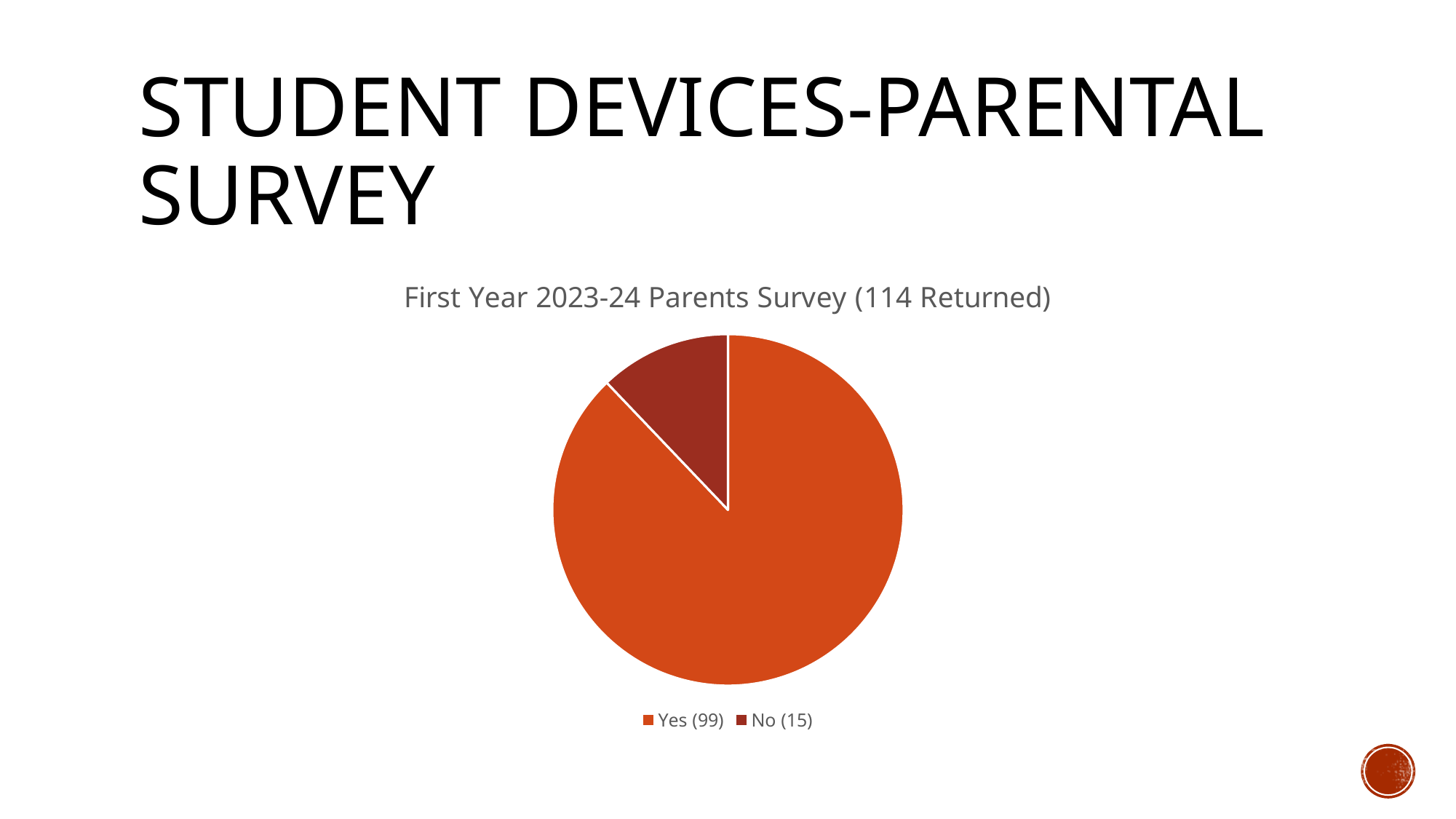
What colour is the Yes slice of the pie? orange What is the difference between the number of Yes and No responses? 84 How many parents answered No according to the legend? 15 How many slices does the pie chart have? 2 Which is larger, the Yes count or the No count? Yes What is the title of the chart? First Year 2023-24 Parents Survey (114 Returned) How many parents answered Yes according to the legend? 99 How many entries does the legend list? 2 What type of chart is shown on the slide? pie chart Which response has the smallest slice of the pie? No Which response has the largest slice of the pie? Yes How many surveys were returned in total, according to the chart title? 114